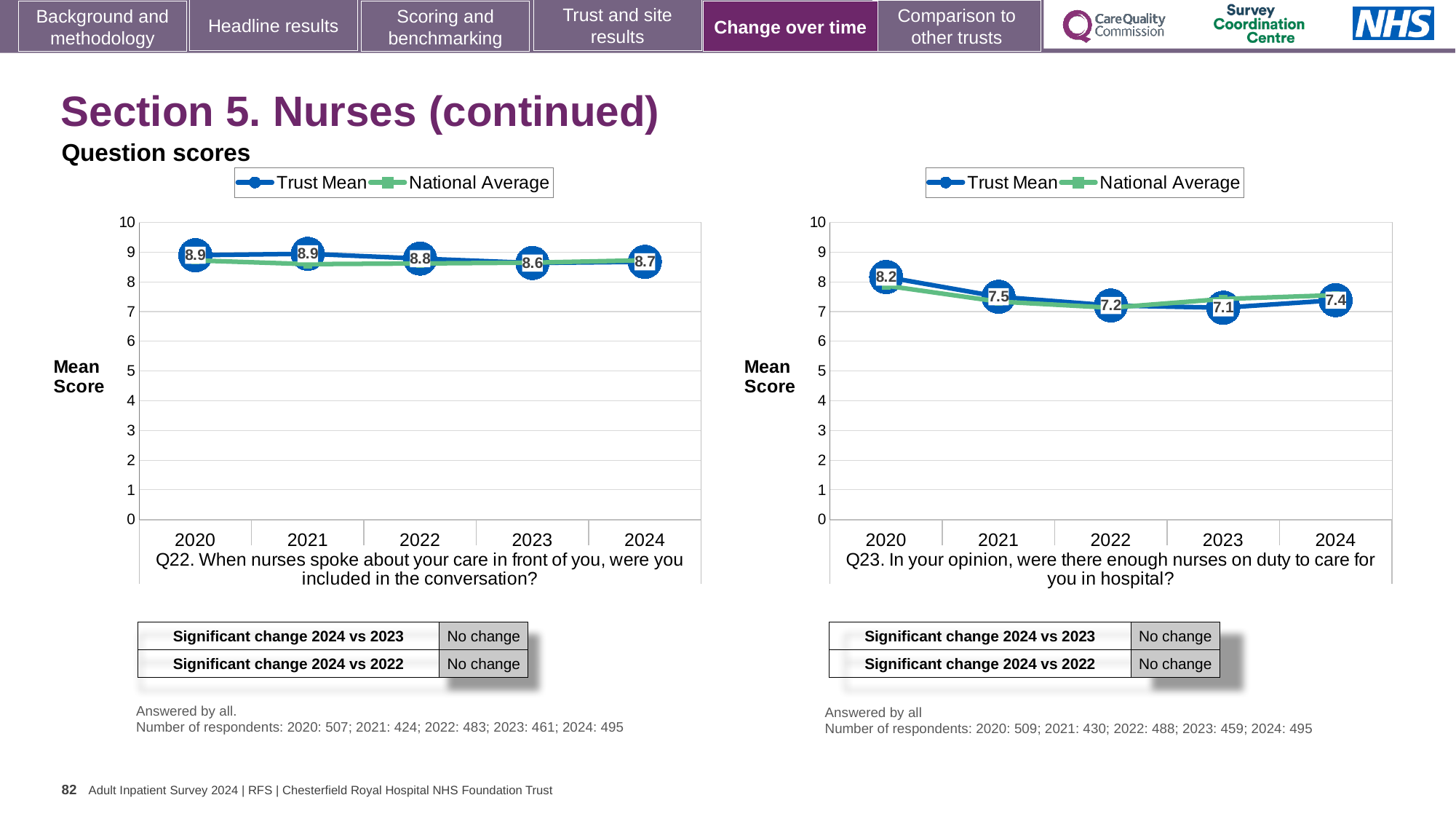
In the Q23 chart, which year has the highest Trust Mean score? 2020 In the Q22 chart, what is the Trust Mean score for 2023? 8.6 In the Q23 chart, what is the difference between the Trust Mean scores for 2020 and 2024? 0.8 In the Q23 chart, is the Trust Mean score for 2021 greater or less than 8? less In the Q22 chart, what is the Trust Mean score for 2020? 8.9 In the Q23 chart, what is the Trust Mean score for 2024? 7.4 In the Q22 chart, what is the difference between the Trust Mean scores for 2021 and 2023? 0.3 What kind of chart is the Q23 chart? Line chart In the Q23 chart, what is the Trust Mean score for 2020? 8.2 In the Q22 chart, which year has the lowest Trust Mean score? 2023 How many series does the legend of the Q22 chart list? 2 In the Q23 chart, which year has the lowest Trust Mean score? 2023